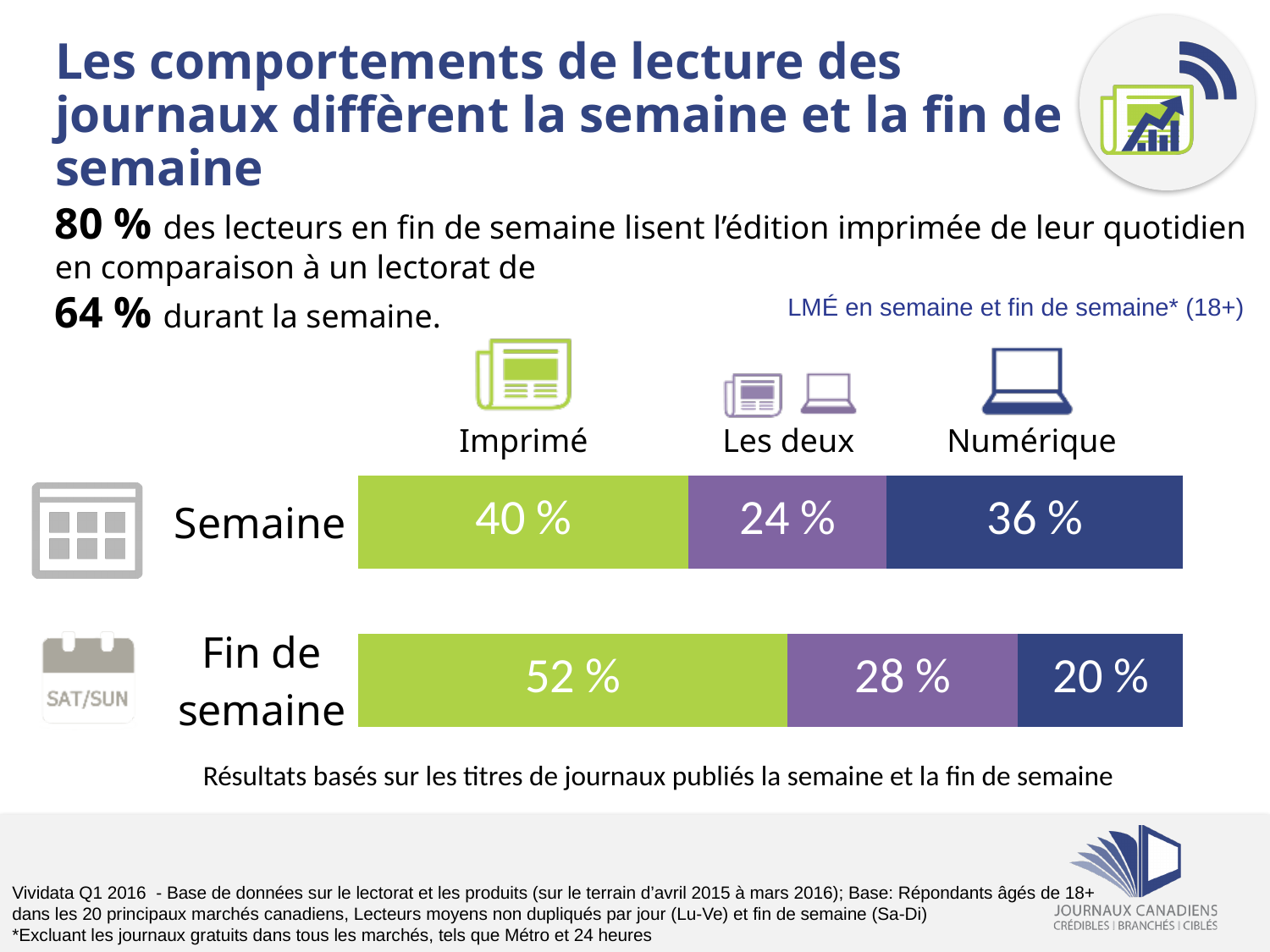
How many categories (rows) does the chart show? 2 Which is larger: the Numérique value for Semaine or for Fin de semaine? Semaine Which segment is the smallest in the Semaine bar? Les deux What is the Imprimé value for Semaine? 40 % What is the Numérique value for Fin de semaine? 20 % What is the total of the Semaine stacked bar? 100 % Which segment is the largest in the Fin de semaine bar? Imprimé What is the Les deux value for Semaine? 24 % How many series does the chart show? 3 What kind of chart is shown on the slide? Stacked bar chart What is the difference between the Imprimé values for Fin de semaine and Semaine? 12 % What is the Imprimé value for Fin de semaine? 52 %